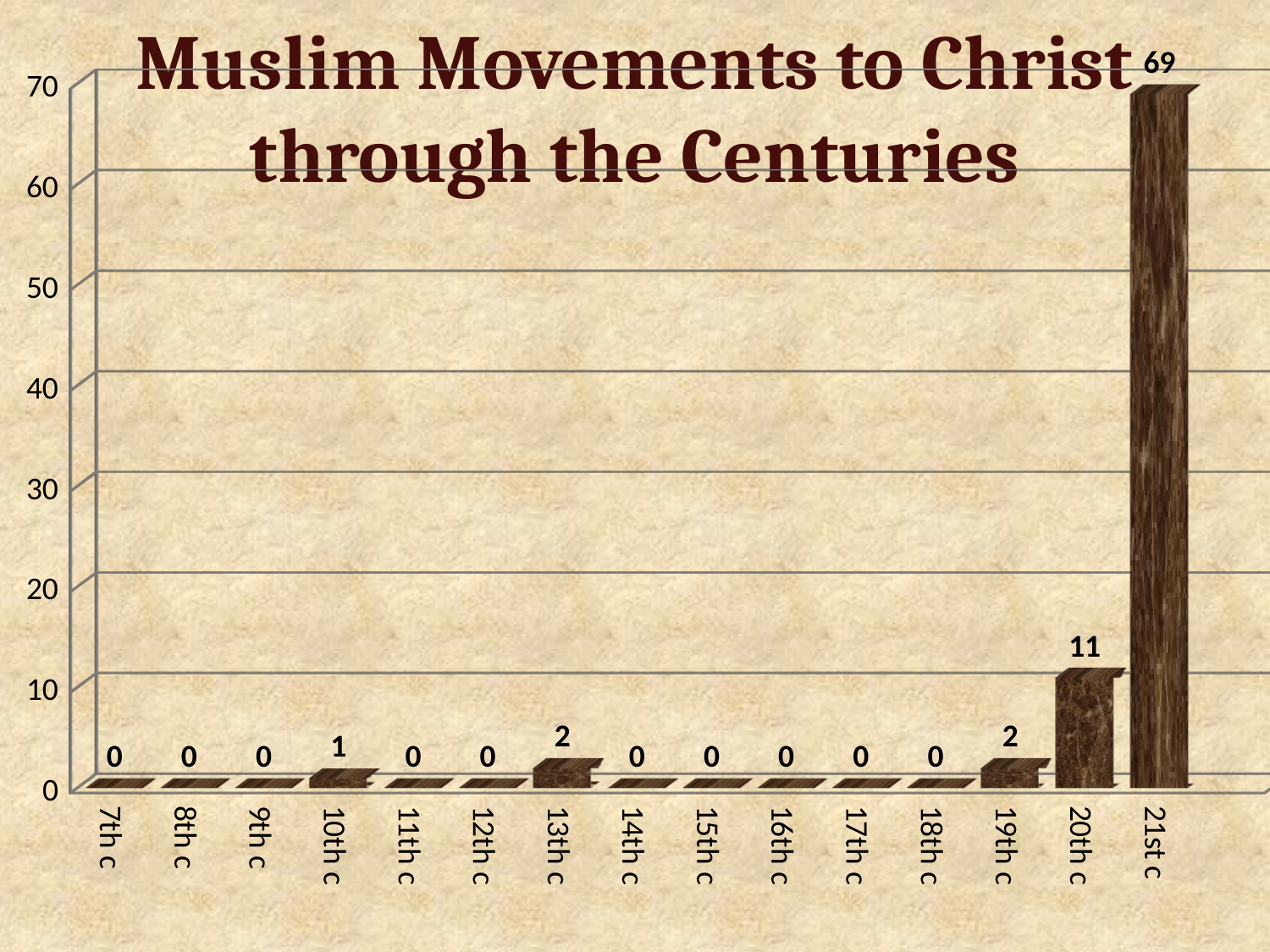
How many centuries have a value of 0? 10 What is the value for the 20th c? 11 What kind of chart is shown on the slide? bar chart What is the difference between the values for the 21st c and the 20th c? 58 What is the title of the chart? Muslim Movements to Christ through the Centuries Is the value for the 21st c greater or less than 60? greater What is the value for the 21st c? 69 Which century has the highest value? 21st c How many centuries are shown on the x axis? 15 What is the value for the 13th c? 2 Which is larger, the value for the 19th c or the value for the 20th c? 20th c What is the value for the 10th c? 1